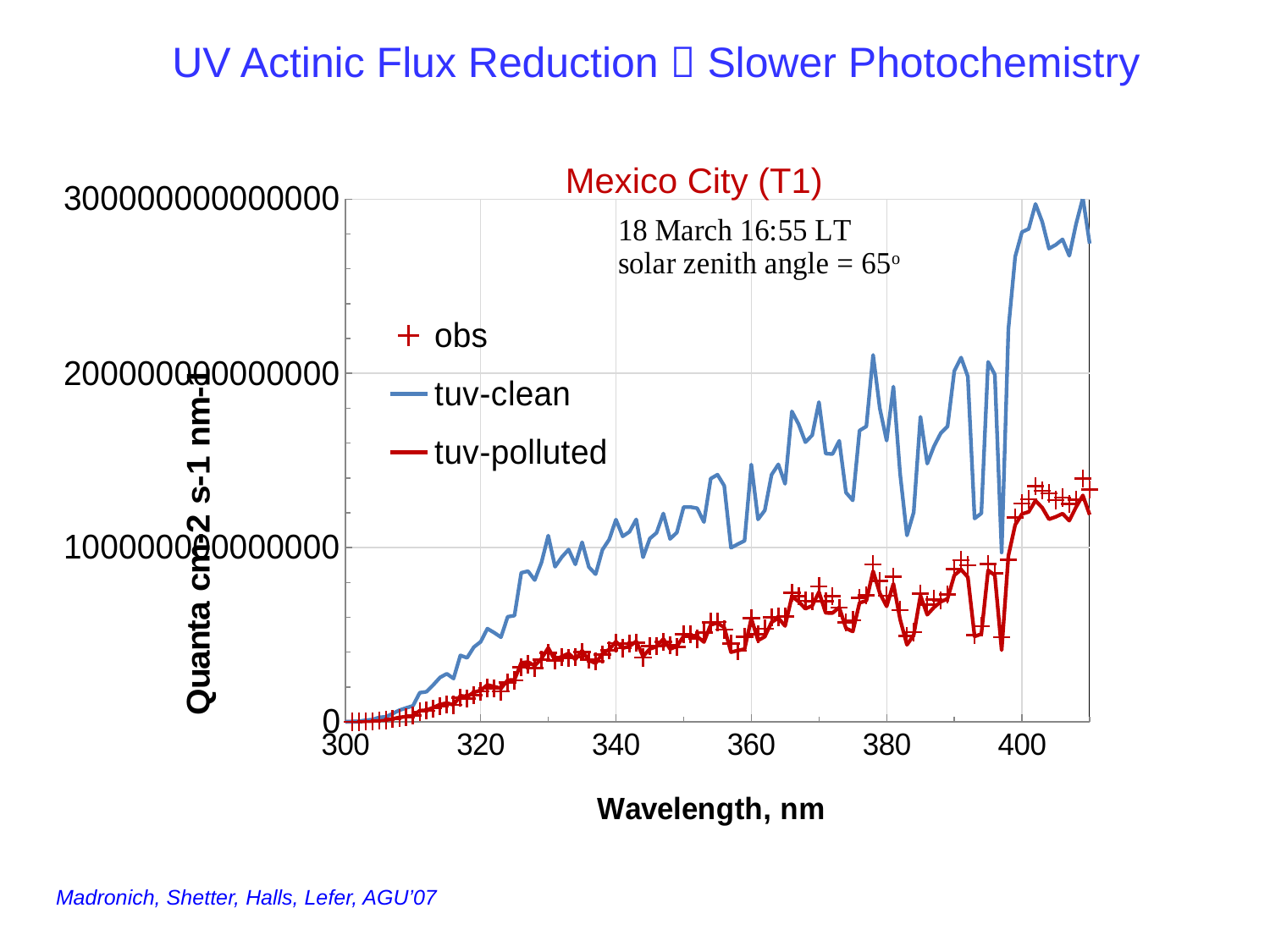
How many series does the legend list? 3 Is the value of tuv-clean at 400 nm greater or less than 200000000000000? greater Which series reaches the highest value on the chart? tuv-clean What is the label of the x axis? Wavelength, nm What is the title of the chart? Mexico City (T1) Do the tuv-polluted values generally rise or fall as wavelength increases from 300 nm to 410 nm? rise Is the value of tuv-clean at 320 nm greater or less than 100000000000000? less What type of chart is shown on the slide? line chart Is the value of tuv-polluted at 405 nm greater or less than 100000000000000? greater Do the tuv-clean values generally rise or fall as wavelength increases from 300 nm to 410 nm? rise At 380 nm, which series has the larger value, tuv-clean or tuv-polluted? tuv-clean